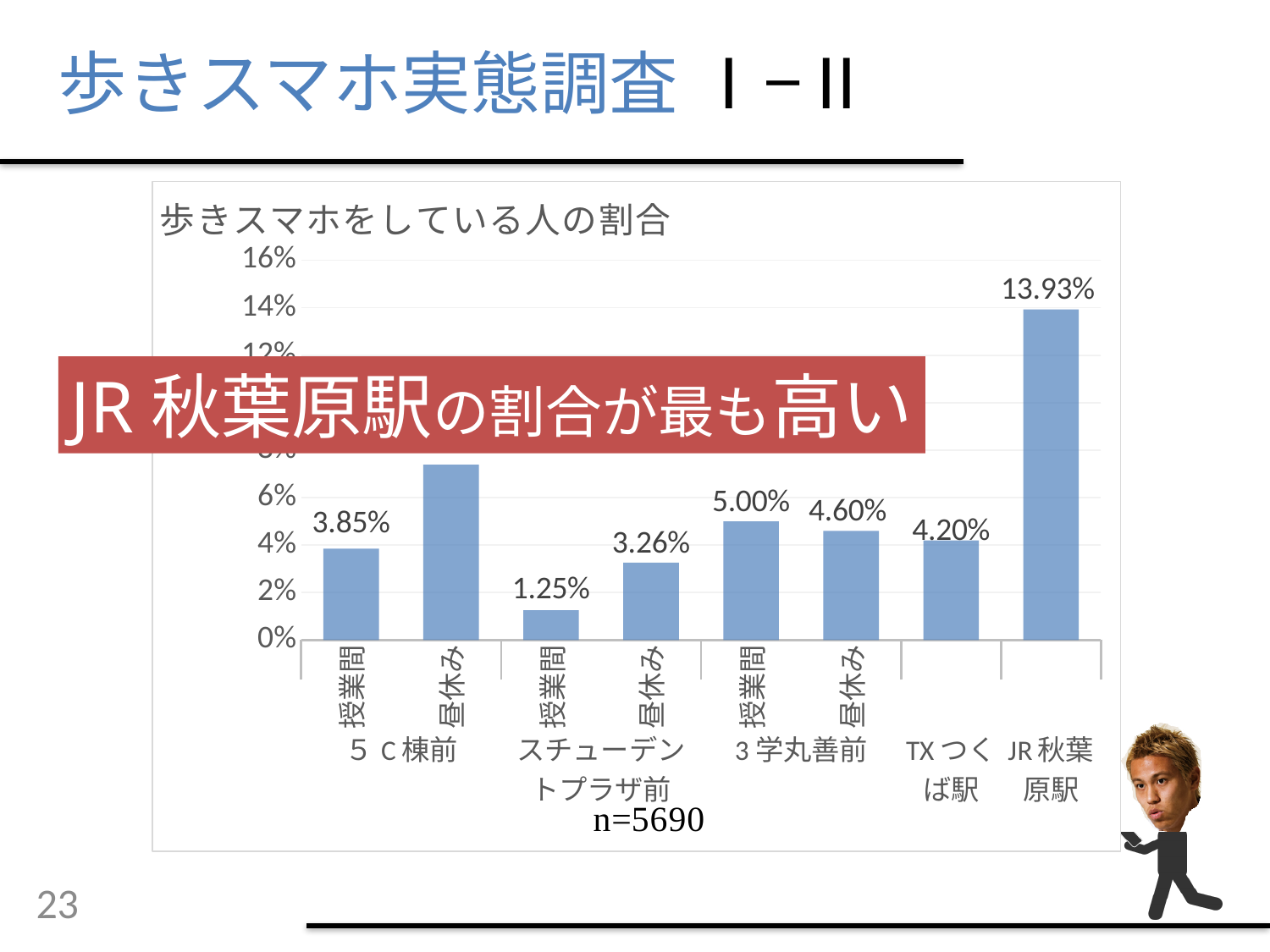
What is the value for 昼休み at 3学丸善前? 4.60% What is the title of the chart? 歩きスマホをしている人の割合 What is the value for 授業間 at 5C棟前? 3.85% Which is larger, the value for 授業間 at 3学丸善前 or the value for 昼休み at 3学丸善前? 授業間 at 3学丸善前 What is the value for JR秋葉原駅? 13.93% What is the value for 授業間 at スチューデントプラザ前? 1.25% How many bars are plotted in the chart? 8 Which bar has the lowest value? 授業間 at スチューデントプラザ前 What is the difference between the value for JR秋葉原駅 and the value for TXつくば駅? 9.73% Which bar has the highest value? JR秋葉原駅 What is the value for 昼休み at スチューデントプラザ前? 3.26% Is the value for 昼休み at 5C棟前 greater or less than 6%? greater